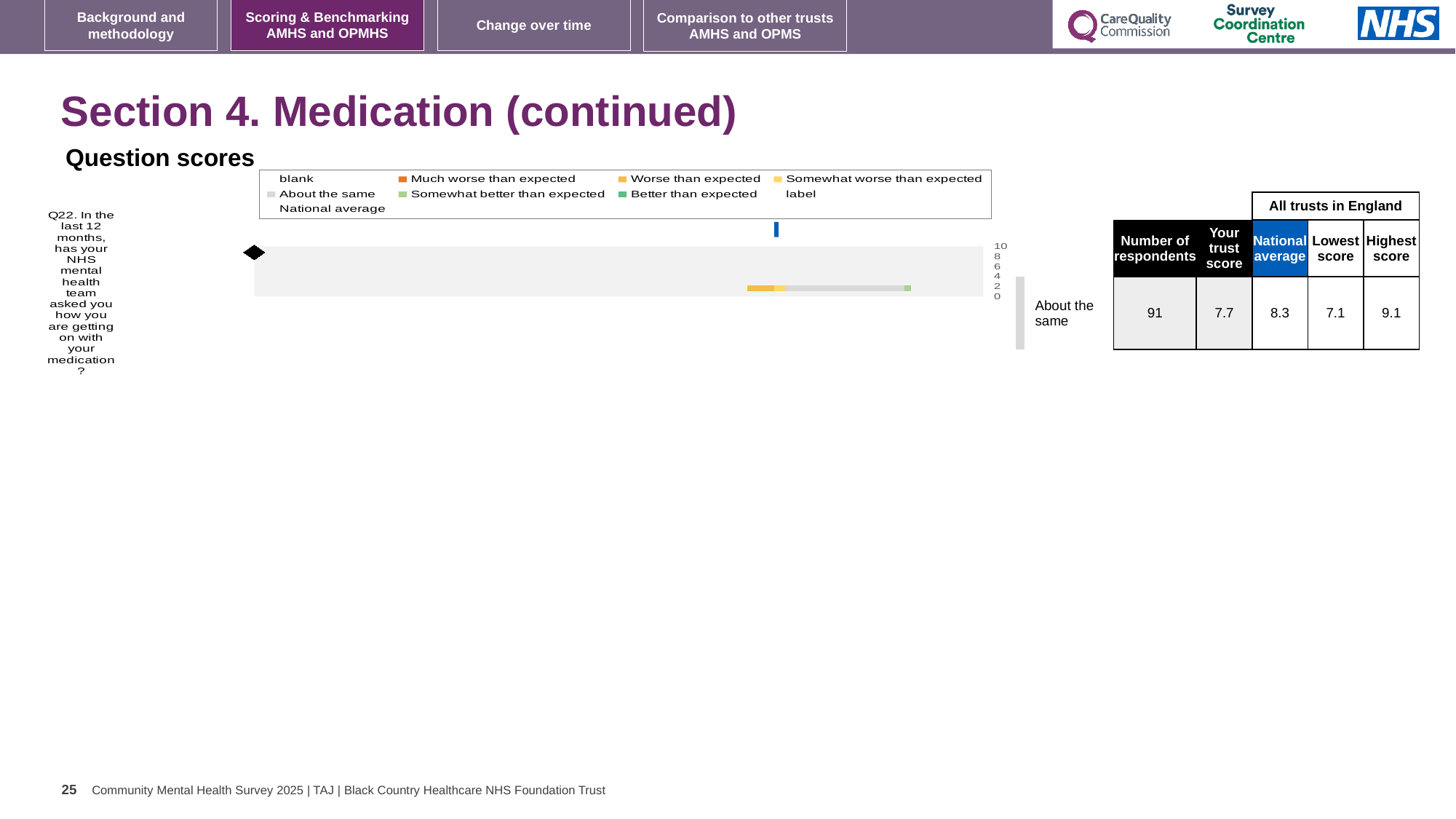
What is the highest tick value shown on the axis of the Question scores chart? 10 How many questions (categories) are plotted in the Question scores chart? 1 What kind of chart is shown under 'Question scores'? bar chart How many respondents answered Q22 according to the table next to the chart? 91 Which question is plotted in the Question scores chart? Q22. In the last 12 months, has your NHS mental health team asked you how you are getting on with your medication? What benchmark category is shown to the right of the bar for Q22? About the same What is the national average for Q22 as shown in the table next to the chart? 8.3 How many entries does the legend of the Question scores chart list? 9 Which is larger for Q22, the trust score or the national average? national average What is the lowest score among all trusts in England for Q22? 7.1 What is the trust's score for Q22 as shown in the table next to the chart? 7.7 What is the highest score among all trusts in England for Q22? 9.1